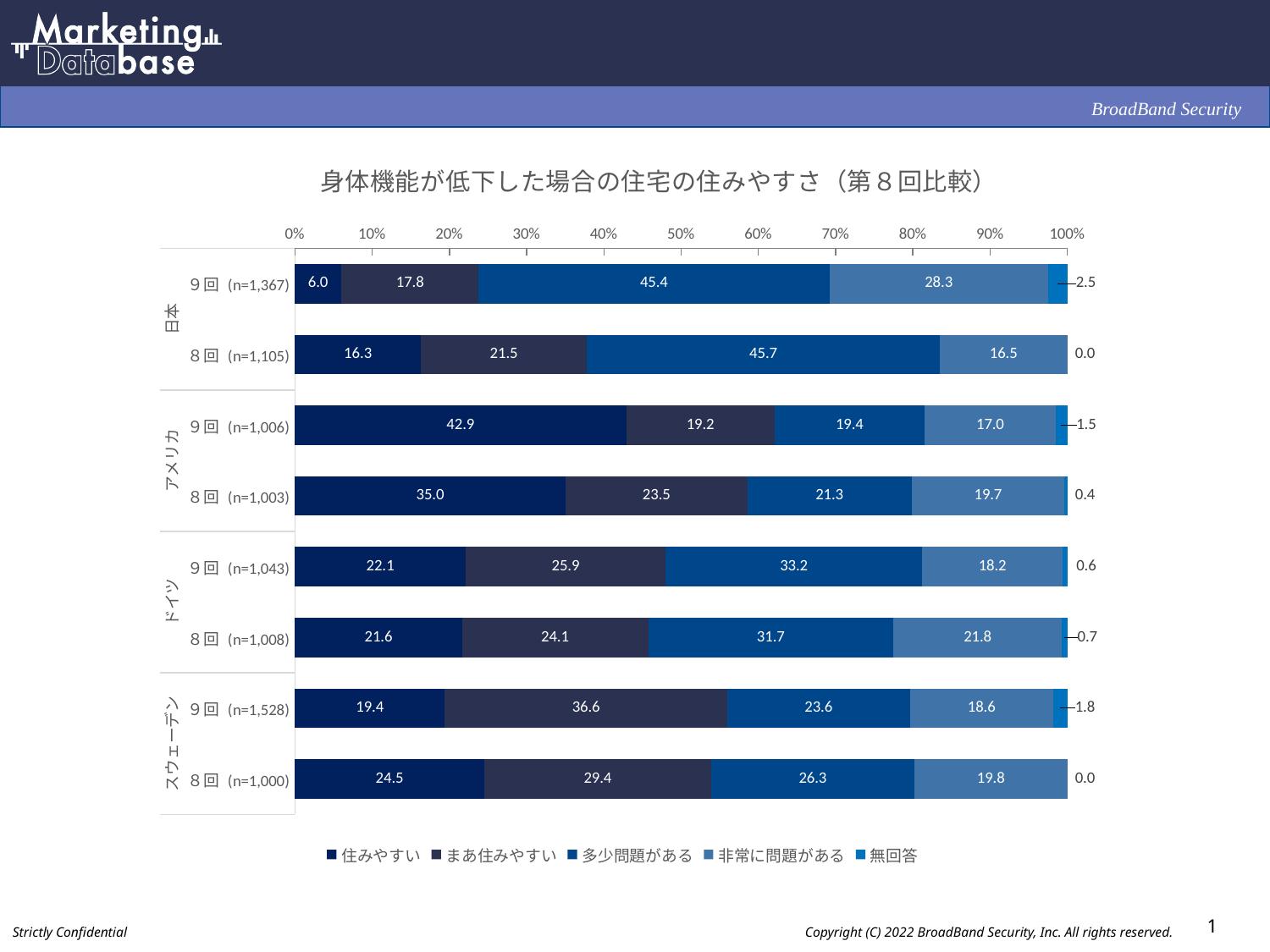
How many series does the legend list? 5 What type of chart is shown on the slide? Stacked bar chart How many bars (survey rounds across countries) are plotted in the chart? 8 What is the difference between the 住みやすい values for アメリカ 9回 (n=1,006) and アメリカ 8回 (n=1,003)? 7.9 What is the value of 多少問題がある for 日本 8回 (n=1,105)? 45.7 Which bar has the lowest value for 住みやすい? 日本 9回 (n=1,367) What is the value of 住みやすい for 日本 9回 (n=1,367)? 6.0 What is the value of まあ住みやすい for スウェーデン 8回 (n=1,000)? 29.4 What is the title of the chart? 身体機能が低下した場合の住宅の住みやすさ（第８回比較） What is the value of 無回答 for スウェーデン 9回 (n=1,528)? 1.8 Which is larger: the 非常に問題がある value for ドイツ 9回 (n=1,043) or for ドイツ 8回 (n=1,008)? ドイツ 8回 (n=1,008) Which bar has the highest value for 住みやすい? アメリカ 9回 (n=1,006)